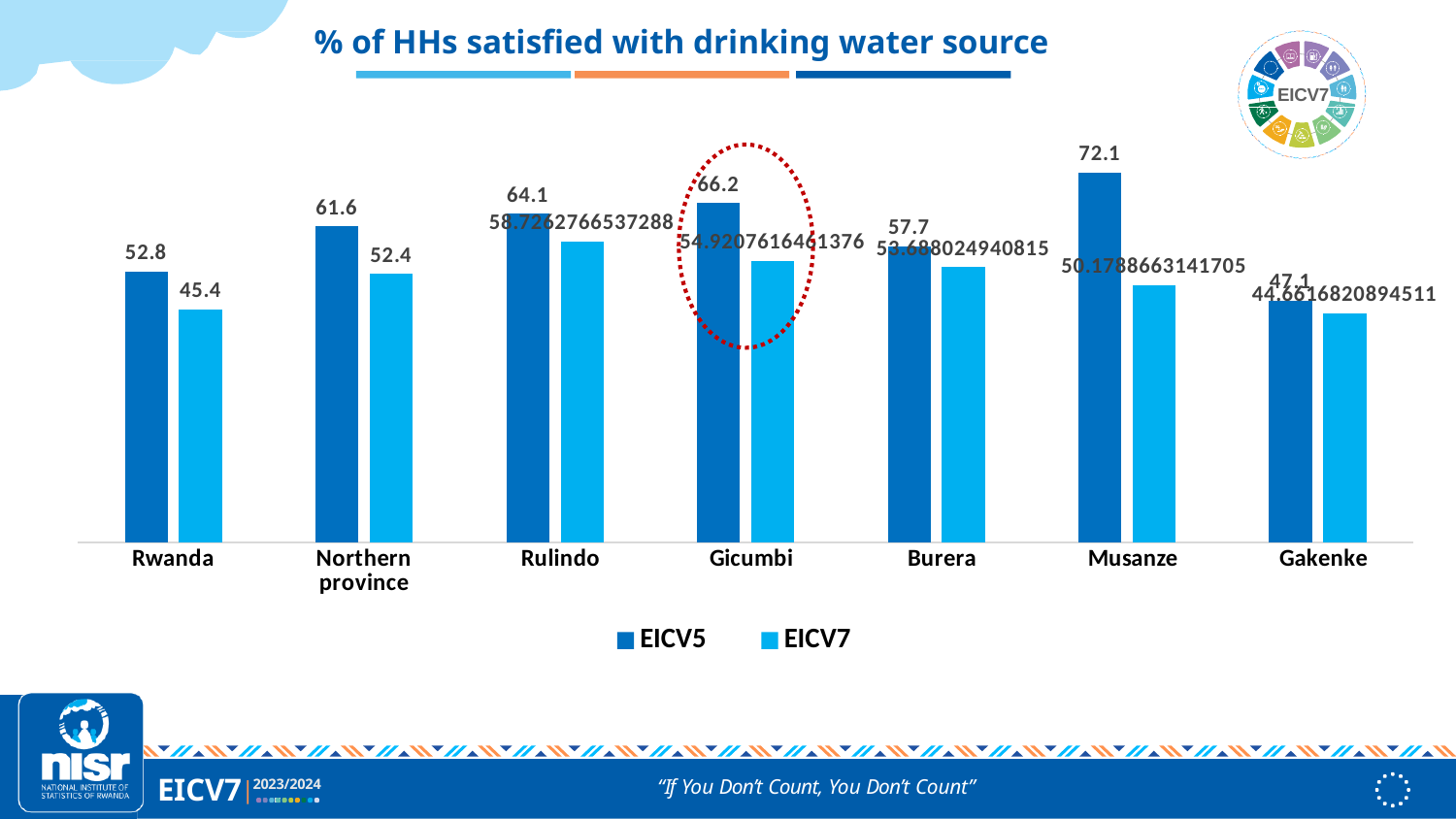
What is the difference between the EICV5 and EICV7 values for Rwanda? 7.4 Which category has the lowest EICV5 value? Gakenke What kind of chart is shown on the slide? bar chart What is the EICV7 value for Musanze? 50.1788663141705 Which has the larger EICV5 value, Gicumbi or Rulindo? Gicumbi What is the title of the chart? % of HHs satisfied with drinking water source Which category has the highest EICV5 value? Musanze How many categories are shown on the x axis? 7 What is the EICV5 value for Musanze? 72.1 How many series does the legend list? 2 What is the EICV7 value for Rwanda? 45.4 What is the EICV5 value for Northern province? 61.6